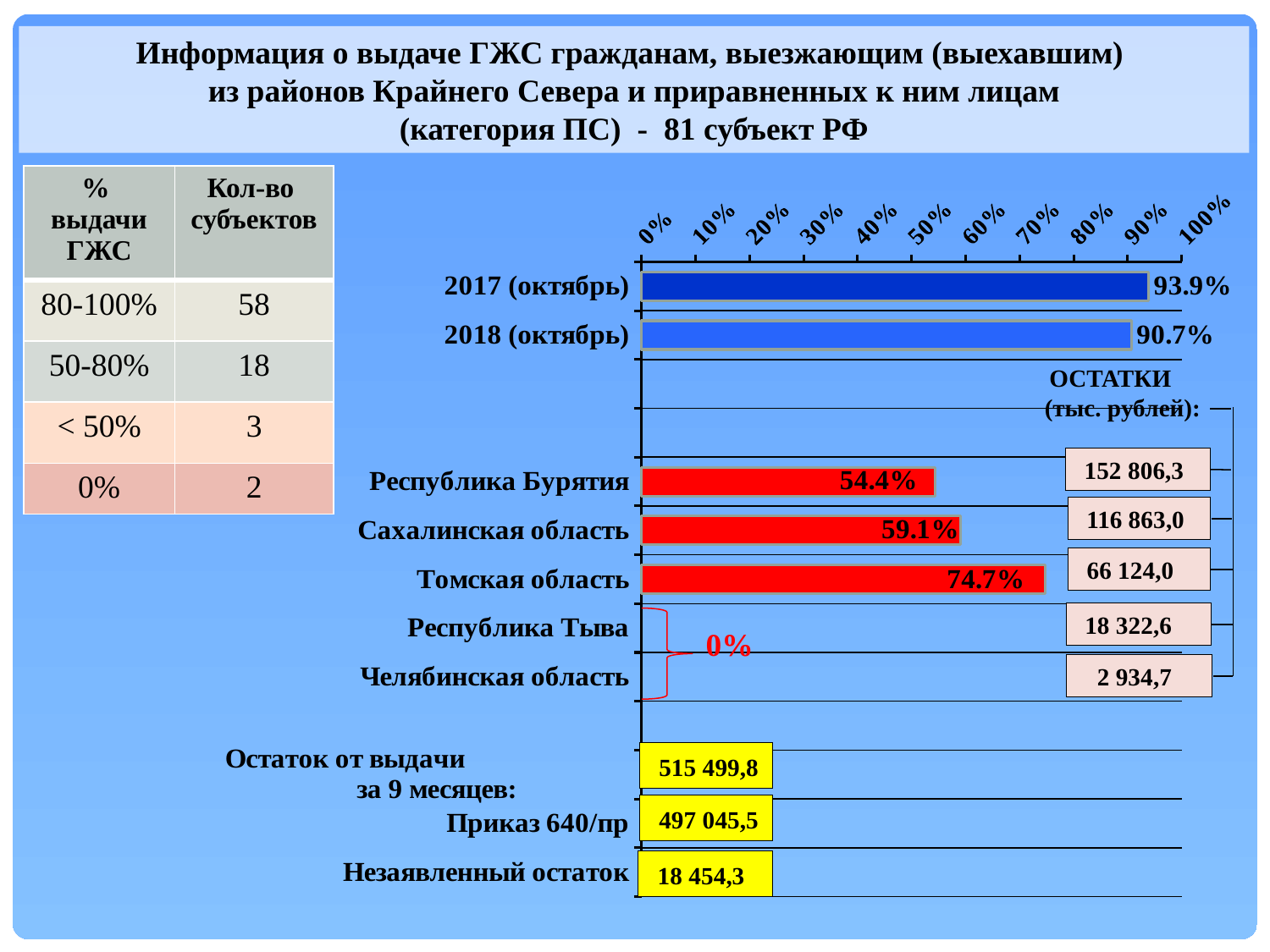
Which of the three red bars (Республика Бурятия, Сахалинская область, Томская область) has the lowest value? Республика Бурятия What is the value for Республика Бурятия? 54.4% What is the difference between the values for 2017 (октябрь) and 2018 (октябрь)? 3.2% What is the value for Сахалинская область? 59.1% Which of the three red bars (Республика Бурятия, Сахалинская область, Томская область) has the highest value? Томская область What is the value for 2018 (октябрь)? 90.7% What value is shown for Республика Тыва and Челябинская область? 0% What is the value for Томская область? 74.7% What kind of chart is shown on the slide? bar chart What is the остатки (тыс. рублей) value shown for Республика Тыва? 18 322,6 What is the value for 2017 (октябрь)? 93.9% Which is larger, the value for Сахалинская область or the value for Республика Бурятия? Сахалинская область